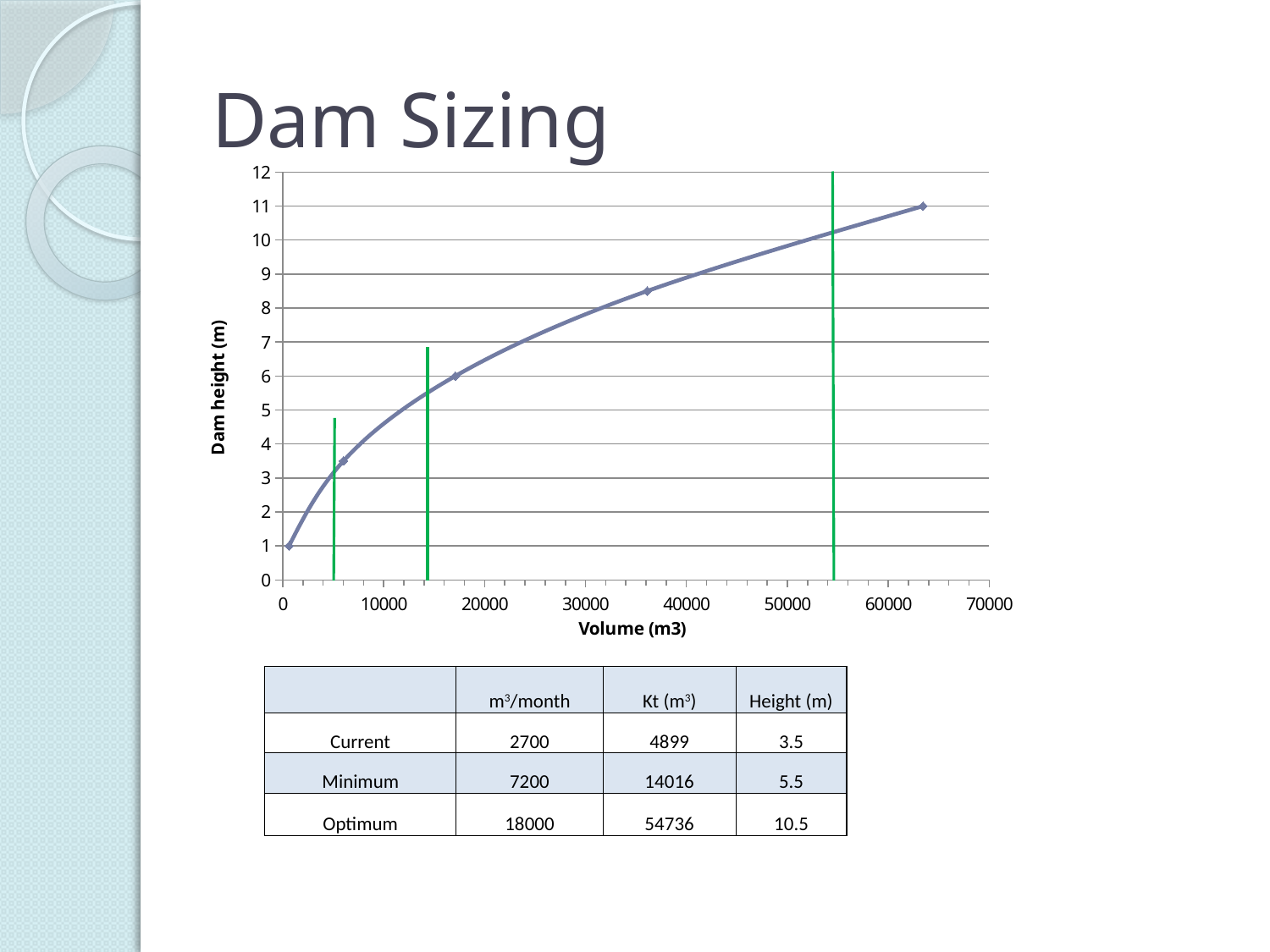
Is the dam height at a volume of 30000 m3 greater or less than 7? greater Is the dam height at a volume of 10000 m3 greater or less than 5? less What kind of chart is shown on the slide? line chart What is the highest dam height value reached by the plotted points? 11 Does dam height rise or fall as volume increases along the x axis? rises Which is larger, the dam height at 20000 m3 or at 50000 m3? 50000 m3 What is the title of the y axis? Dam height (m) Is the dam height at a volume of 40000 m3 greater or less than 10? less What is the title of the x axis? Volume (m3) How many data points are marked on the curve? 5